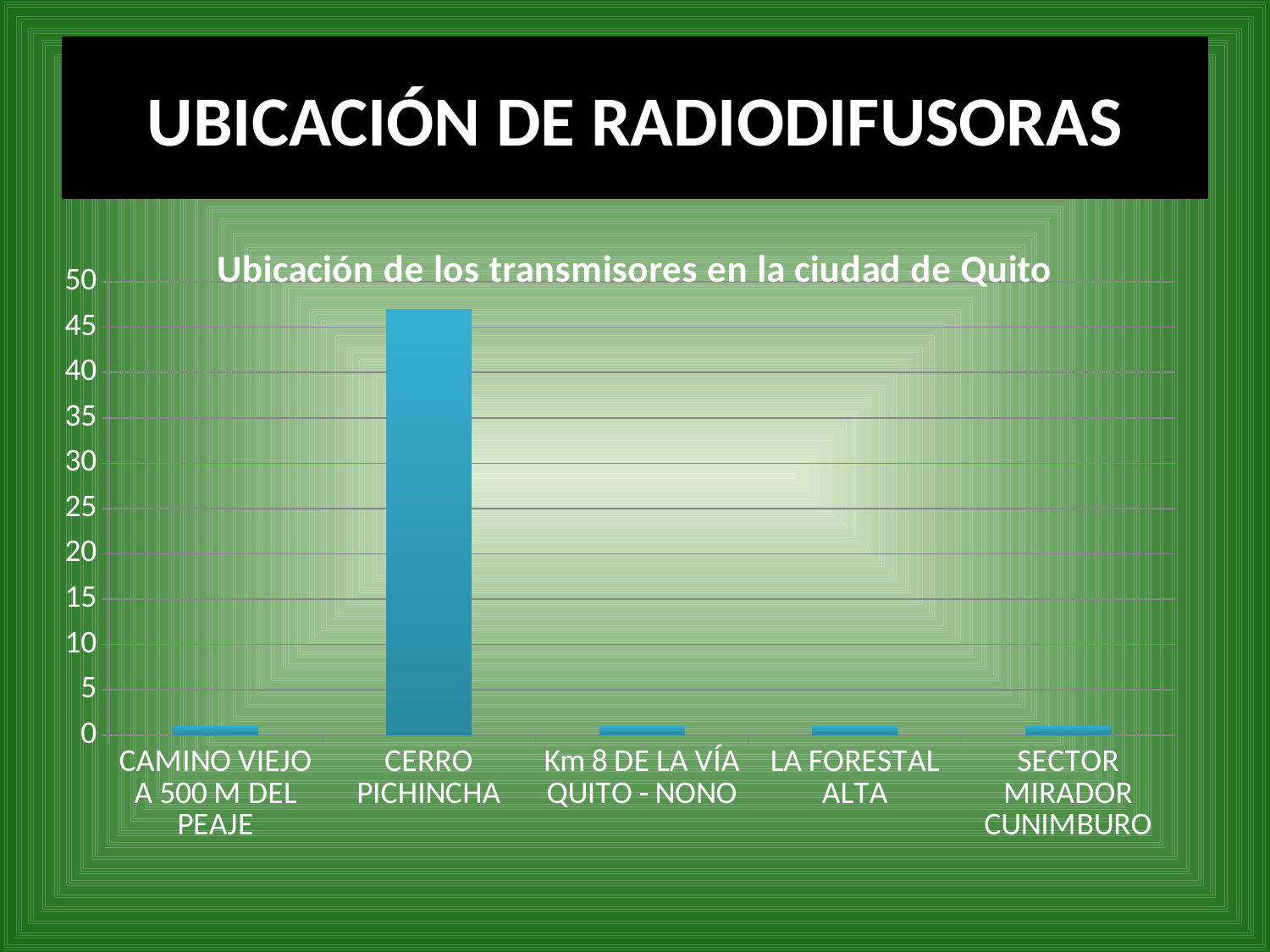
Which has a larger value, CERRO PICHINCHA or CAMINO VIEJO A 500 M DEL PEAJE? CERRO PICHINCHA How many categories (locations) are shown on the x axis of the chart? 5 What kind of chart is shown on the slide? bar chart Which location has the highest value in the chart? CERRO PICHINCHA Which has a larger value, LA FORESTAL ALTA or CERRO PICHINCHA? CERRO PICHINCHA Is the value for LA FORESTAL ALTA greater or less than 5? less What is the title of the chart? Ubicación de los transmisores en la ciudad de Quito Is the value for CERRO PICHINCHA greater or less than 50? less Is the value for SECTOR MIRADOR CUNIMBURO greater or less than 5? less What is the highest value shown on the vertical axis of the chart? 50